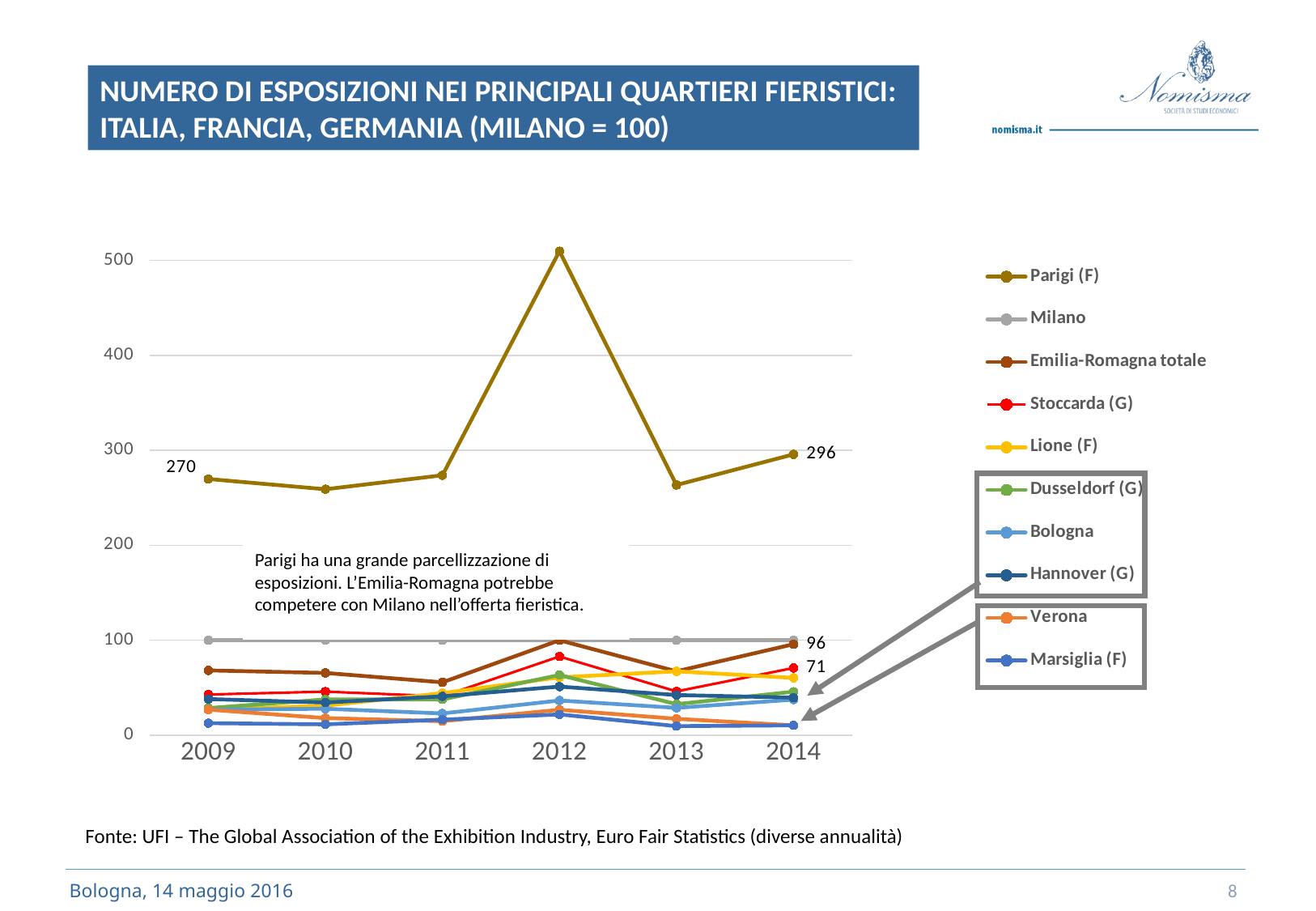
What kind of chart is shown on the slide? Line chart In 2014, which is larger: Emilia-Romagna totale or Stoccarda (G)? Emilia-Romagna totale What is the value for Parigi (F) in 2009? 270 Is the value for Parigi (F) in 2013 greater or less than 300? less What is the value for Stoccarda (G) in 2014? 71 What is the value for Emilia-Romagna totale in 2014? 96 How many years are shown on the x axis? 6 By how much did the value for Parigi (F) change between 2009 and 2014? 26 How many series does the legend list? 10 What is the value for Parigi (F) in 2014? 296 What is the value for Milano in 2010? 100 Which series has the highest value in 2012? Parigi (F)